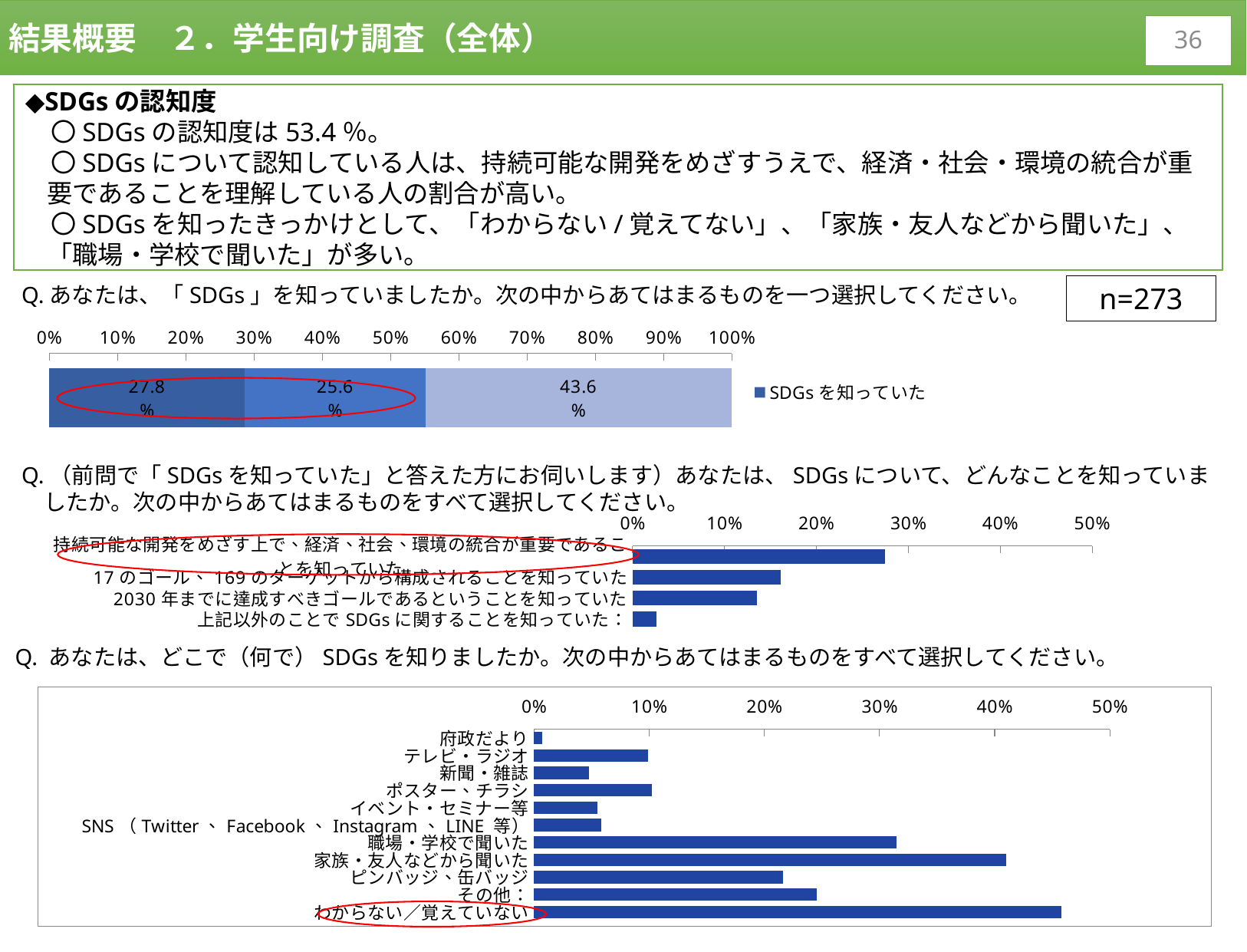
In the middle chart (what respondents knew about SDGs), is the value for 持続可能な開発をめざす上で、経済、社会、環境の統合が重要であることを知っていた greater or less than 20%? greater In the middle chart (what respondents knew about SDGs), how many categories are plotted? 4 In the bottom chart (where respondents learned about SDGs), which category has the lowest value? 府政だより In the top stacked bar chart, what is the value of the rightmost (lightest blue) segment? 43.6% In the middle chart (what respondents knew about SDGs), which category has the longest bar? 持続可能な開発をめざす上で、経済、社会、環境の統合が重要であることを知っていた In the top stacked bar chart, what is the difference between the rightmost segment (43.6%) and the leftmost segment (27.8%)? 15.8 percentage points In the bottom chart (where respondents learned about SDGs), how many categories are plotted? 11 What kind of chart is the top chart showing 27.8%, 25.6% and 43.6%? Bar chart (stacked horizontal) In the top stacked bar chart, which is larger, the leftmost segment or the middle segment? The leftmost segment (27.8%) In the bottom chart (where respondents learned about SDGs), which category has the highest value? わからない／覚えていない In the top stacked bar chart, what is the value of the leftmost (darkest blue) segment? 27.8% In the bottom chart (where respondents learned about SDGs), which is larger, 職場・学校で聞いた or 家族・友人などから聞いた? 家族・友人などから聞いた